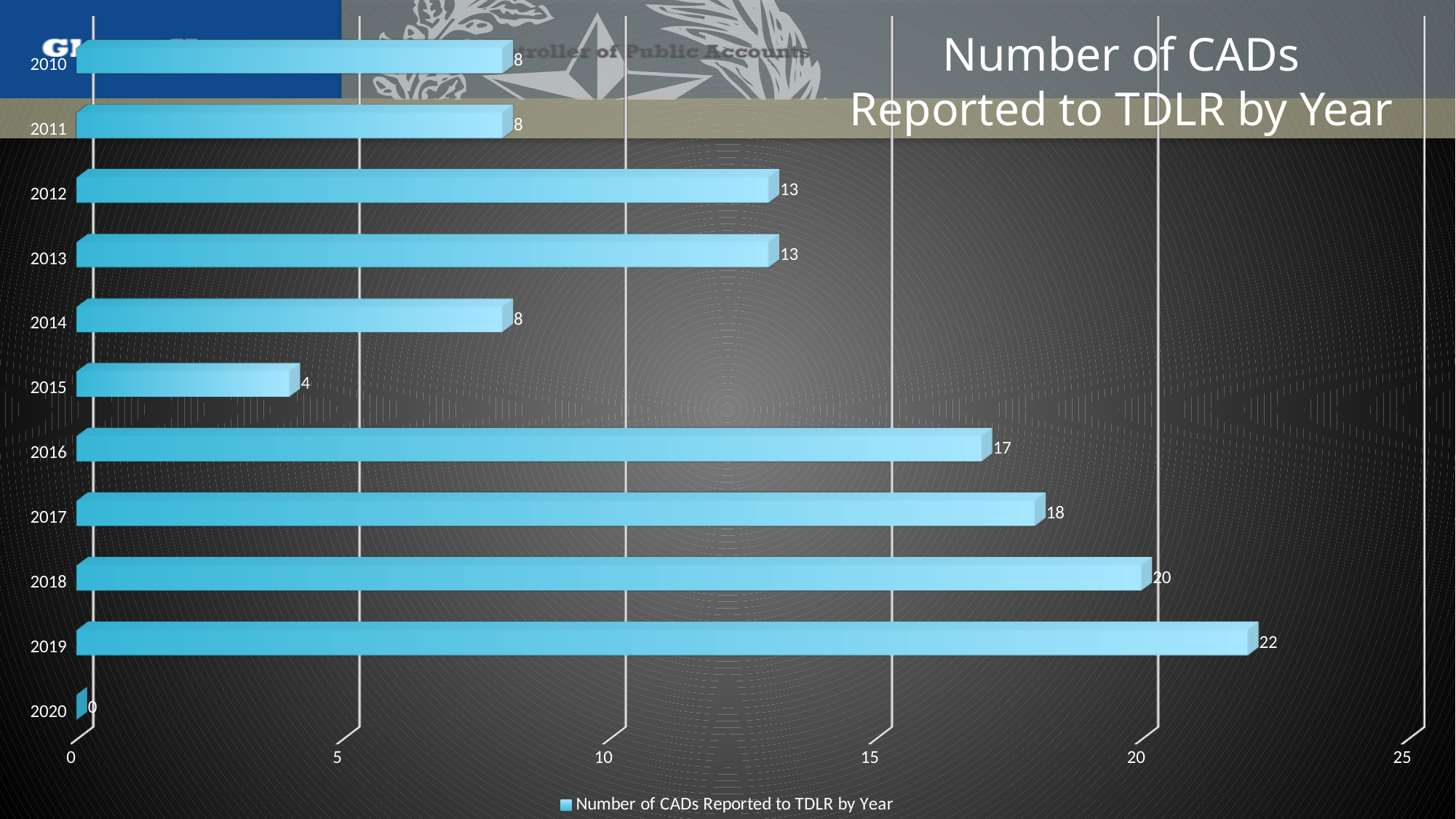
Which year has the highest number of CADs reported to TDLR? 2019 Which year had more CADs reported to TDLR, 2012 or 2014? 2012 What is the number of CADs reported to TDLR in 2015? 4 What is the difference between the number of CADs reported in 2019 and in 2018? 2 What is the title of the chart? Number of CADs Reported to TDLR by Year What is the number of CADs reported to TDLR in 2019? 22 What is the difference between the number of CADs reported in 2016 and in 2015? 13 How many years are shown on the chart? 11 What kind of chart is shown on the slide? Bar chart What is the number of CADs reported to TDLR in 2017? 18 How many series does the legend list? 1 Which year has the lowest number of CADs reported to TDLR? 2020